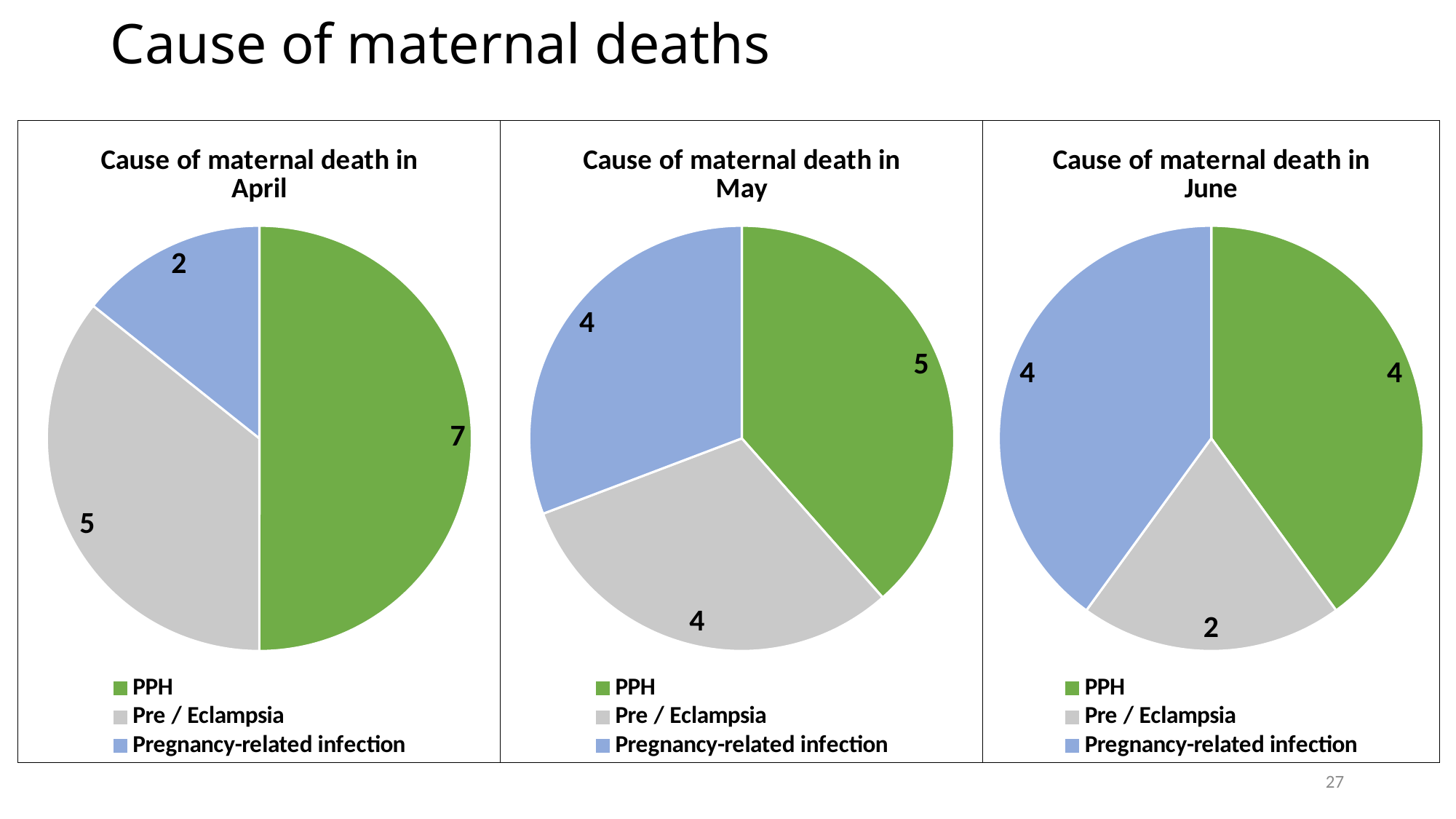
In the 'Cause of maternal death in June' chart, what is the value for Pregnancy-related infection? 4 In the 'Cause of maternal death in June' chart, what share of the pie does Pre / Eclampsia represent? 20% In the 'Cause of maternal death in May' chart, what is the value for Pre / Eclampsia? 4 In the 'Cause of maternal death in April' chart, what is the difference between the PPH value and the Pregnancy-related infection value? 5 In the 'Cause of maternal death in April' chart, what is the value for PPH? 7 In the 'Cause of maternal death in June' chart, which cause has the lowest value? Pre / Eclampsia Which is larger: the PPH value in the April chart or the PPH value in the May chart? April In the 'Cause of maternal death in May' chart, which cause has the highest value? PPH What type of chart is used for 'Cause of maternal death in June'? Pie chart In the 'Cause of maternal death in April' chart, which cause has the lowest value? Pregnancy-related infection How many slices does the 'Cause of maternal death in May' chart have? 3 In the 'Cause of maternal death in April' chart, what share of the pie does PPH represent? 50%